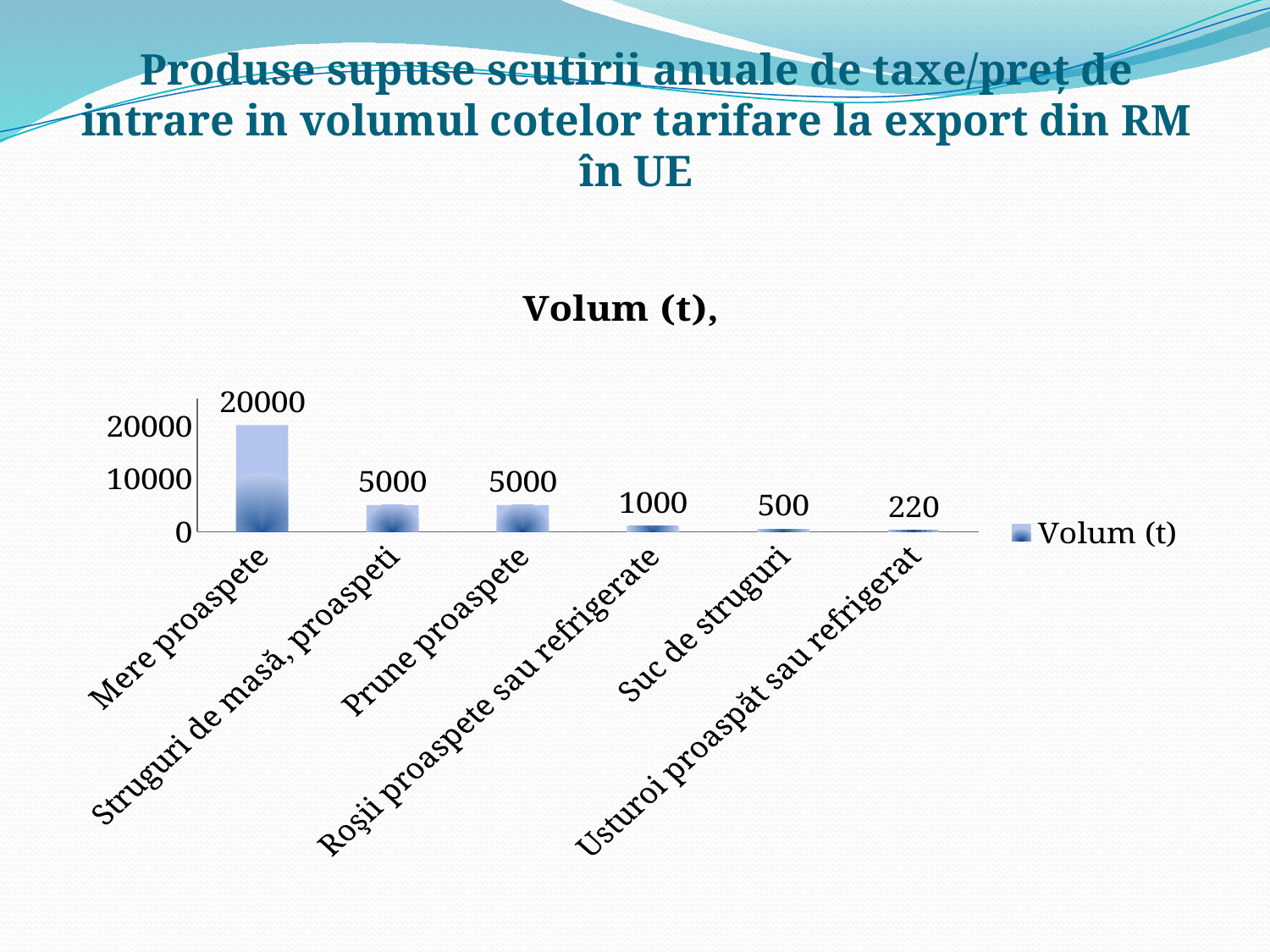
Which category has the lowest value? Usturoi proaspăt sau refrigerat What is the difference between the values for Mere proaspete and Prune proaspete? 15000 What is the value for Mere proaspete? 20000 How many series does the legend list? 1 How many categories are shown on the x axis? 6 What is the title of the chart? Volum (t), What kind of chart is shown? bar chart What is the value for Roșii proaspete sau refrigerate? 1000 What is the value for Suc de struguri? 500 Which is larger, the value for Suc de struguri or the value for Roșii proaspete sau refrigerate? Roșii proaspete sau refrigerate What is the value for Usturoi proaspăt sau refrigerat? 220 Which category has the highest value? Mere proaspete